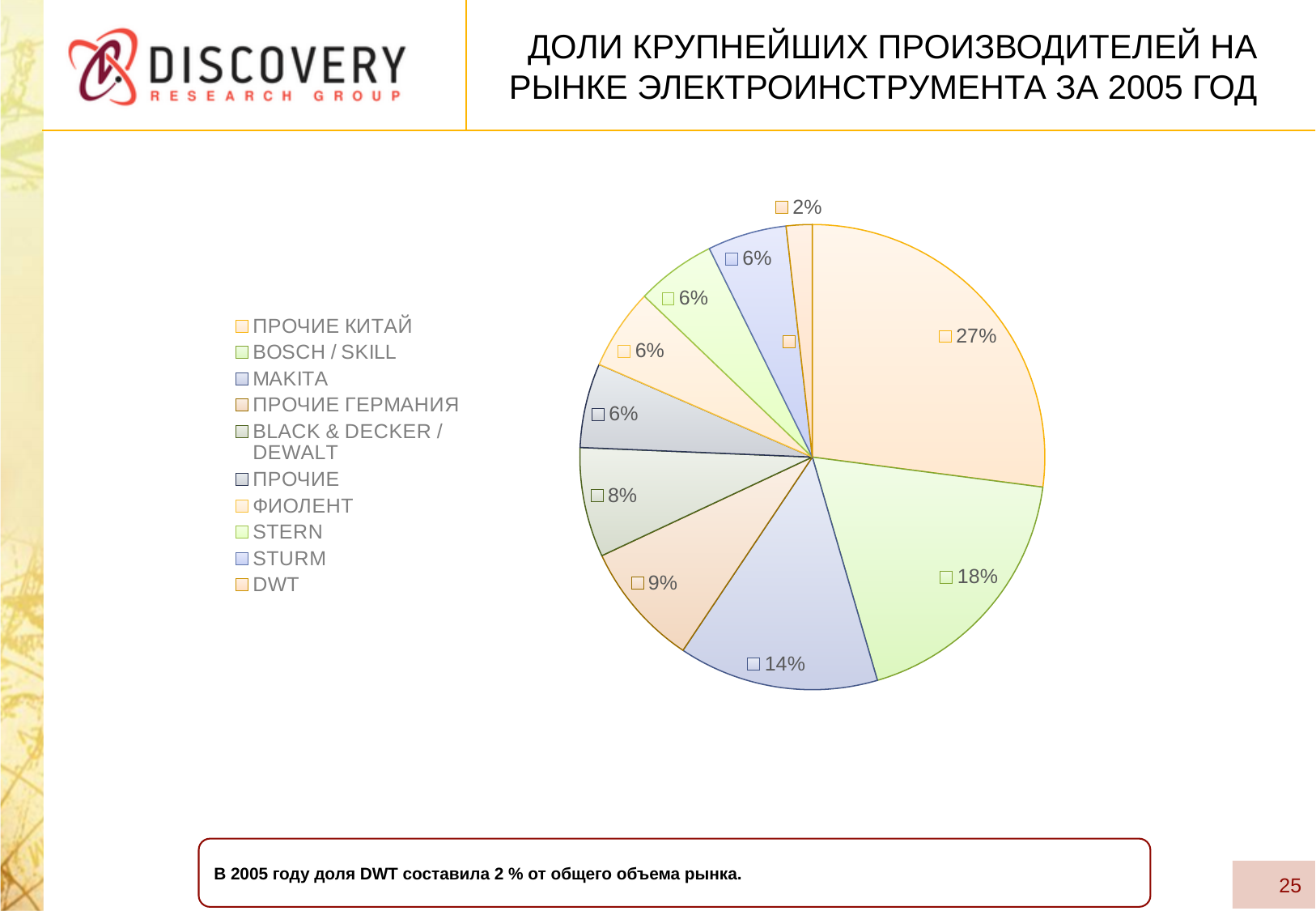
What is the share for BLACK & DECKER / DEWALT? 8% What is the share for DWT? 2% By how many percentage points does ПРОЧИЕ КИТАЙ exceed BOSCH / SKILL? 9 percentage points What is the share for BOSCH / SKILL? 18% What is the share for ПРОЧИЕ ГЕРМАНИЯ? 9% How many categories are listed in the chart legend? 10 What share of the market does ПРОЧИЕ КИТАЙ hold in the pie chart? 27% Which category has the largest slice of the pie? ПРОЧИЕ КИТАЙ Which is larger, the share of MAKITA or the share of ПРОЧИЕ ГЕРМАНИЯ? MAKITA Which category has the smallest labelled slice of the pie? DWT What kind of chart is shown on the slide? pie chart What is the share for MAKITA? 14%